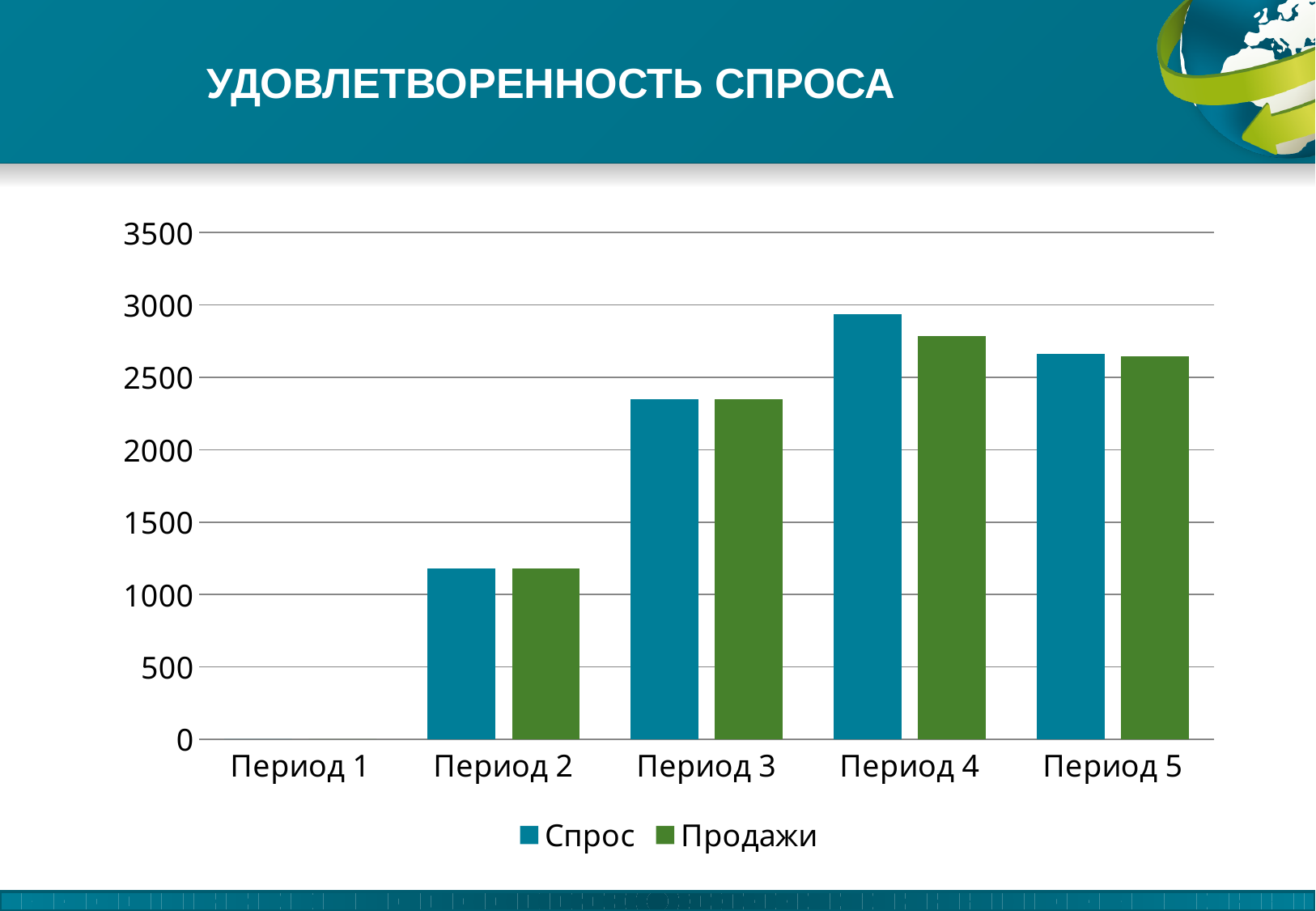
Is the value for Продажи in Период 3 greater or less than 2500? less What kind of chart is shown on the slide? bar chart Is the value for Спрос in Период 4 greater or less than 3000? less How many periods are shown on the x axis? 5 Is the value for Спрос in Период 2 greater or less than 1000? greater Do the Спрос values rise or fall from Период 2 to Период 4? rise How many series does the legend list? 2 Which period has the highest value for Продажи? Период 4 Which colour represents the Продажи series? green In Период 4, which is larger, Спрос or Продажи? Спрос Which period has the highest value for Спрос? Период 4